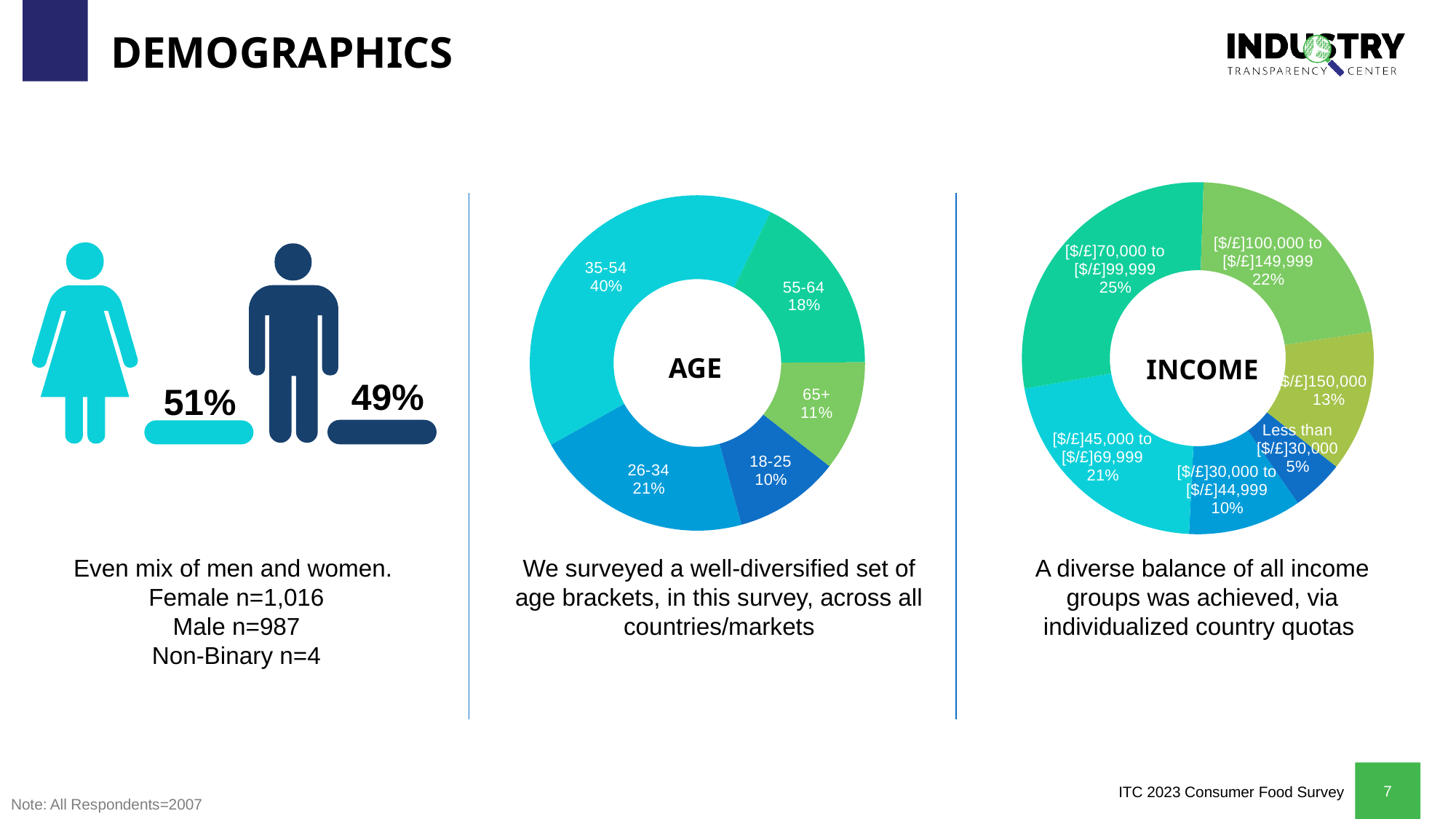
In the INCOME chart, which is larger: the share for [$/£]45,000 to [$/£]69,999 or the share for [$/£]30,000 to [$/£]44,999? [$/£]45,000 to [$/£]69,999 In the INCOME chart, what share of respondents earn less than [$/£]30,000? 5% How many income groups are shown in the INCOME chart? 6 In the AGE chart, what share of respondents are aged 26-34? 21% In the AGE chart, which age bracket has the smallest share? 18-25 In the AGE chart, which age bracket has the largest share? 35-54 In the AGE chart, what share of respondents are aged 35-54? 40% In the INCOME chart, which income group has the largest share? [$/£]70,000 to [$/£]99,999 What kind of chart is the AGE chart? Donut (pie) chart In the INCOME chart, what share of respondents earn [$/£]70,000 to [$/£]99,999? 25% How many age brackets are shown in the AGE chart? 5 In the AGE chart, what is the difference in percentage points between the 55-64 and 65+ brackets? 7